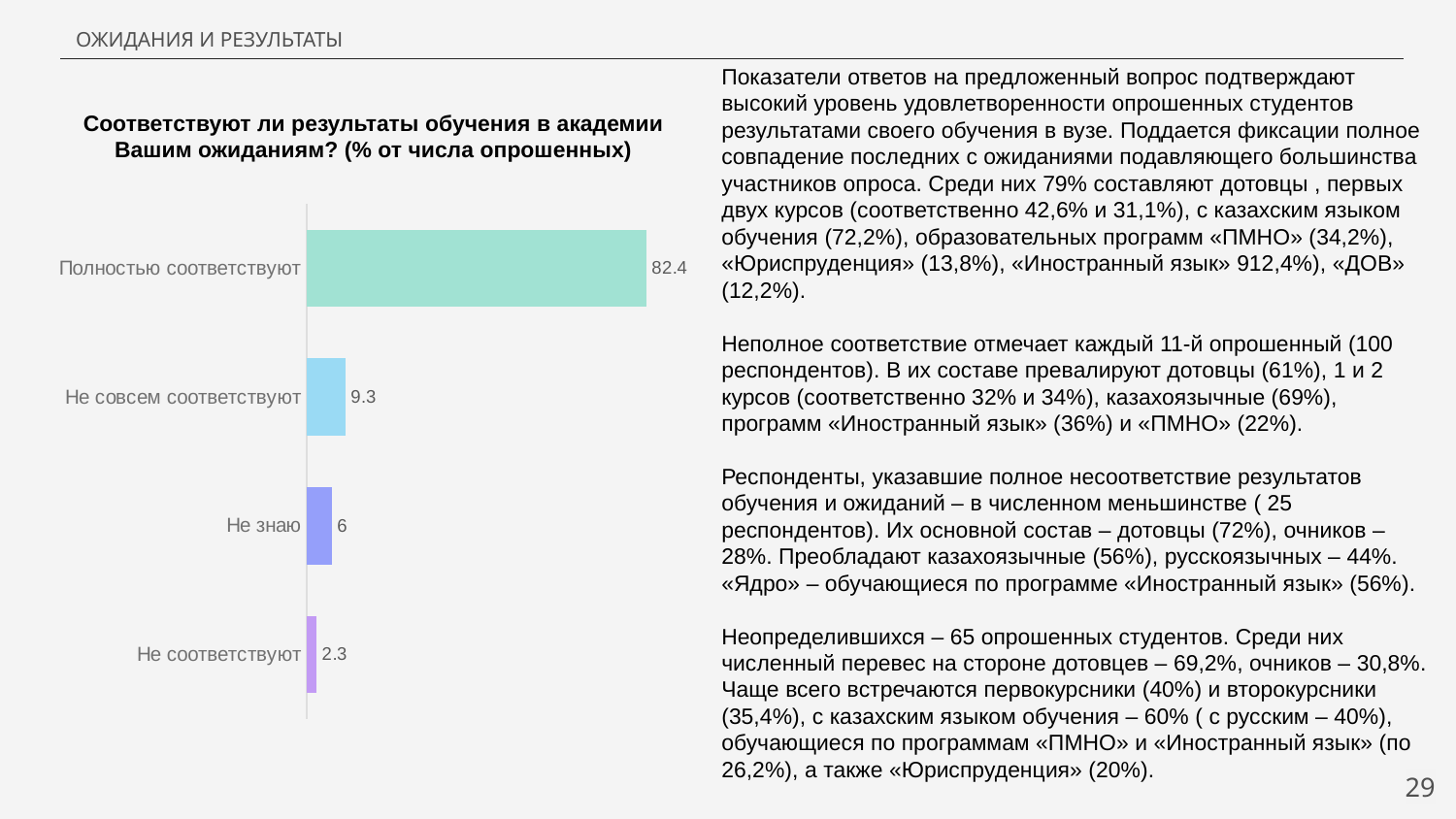
What is the value for «Не совсем соответствуют»? 9.3 Which is larger: the value for «Не совсем соответствуют» or the value for «Не знаю»? Не совсем соответствуют How many categories are shown in the chart? 4 What is the difference between the values for «Не знаю» and «Не соответствуют»? 3.7 What is the difference between the values for «Полностью соответствуют» and «Не совсем соответствуют»? 73.1 What is the value for «Не соответствуют»? 2.3 What is the title of the chart? Соответствуют ли результаты обучения в академии Вашим ожиданиям? (% от числа опрошенных) Which category has the lowest value? Не соответствуют What is the value for «Не знаю»? 6 What is the value for «Полностью соответствуют»? 82.4 Which category has the highest value? Полностью соответствуют What kind of chart is shown on the slide? Bar chart